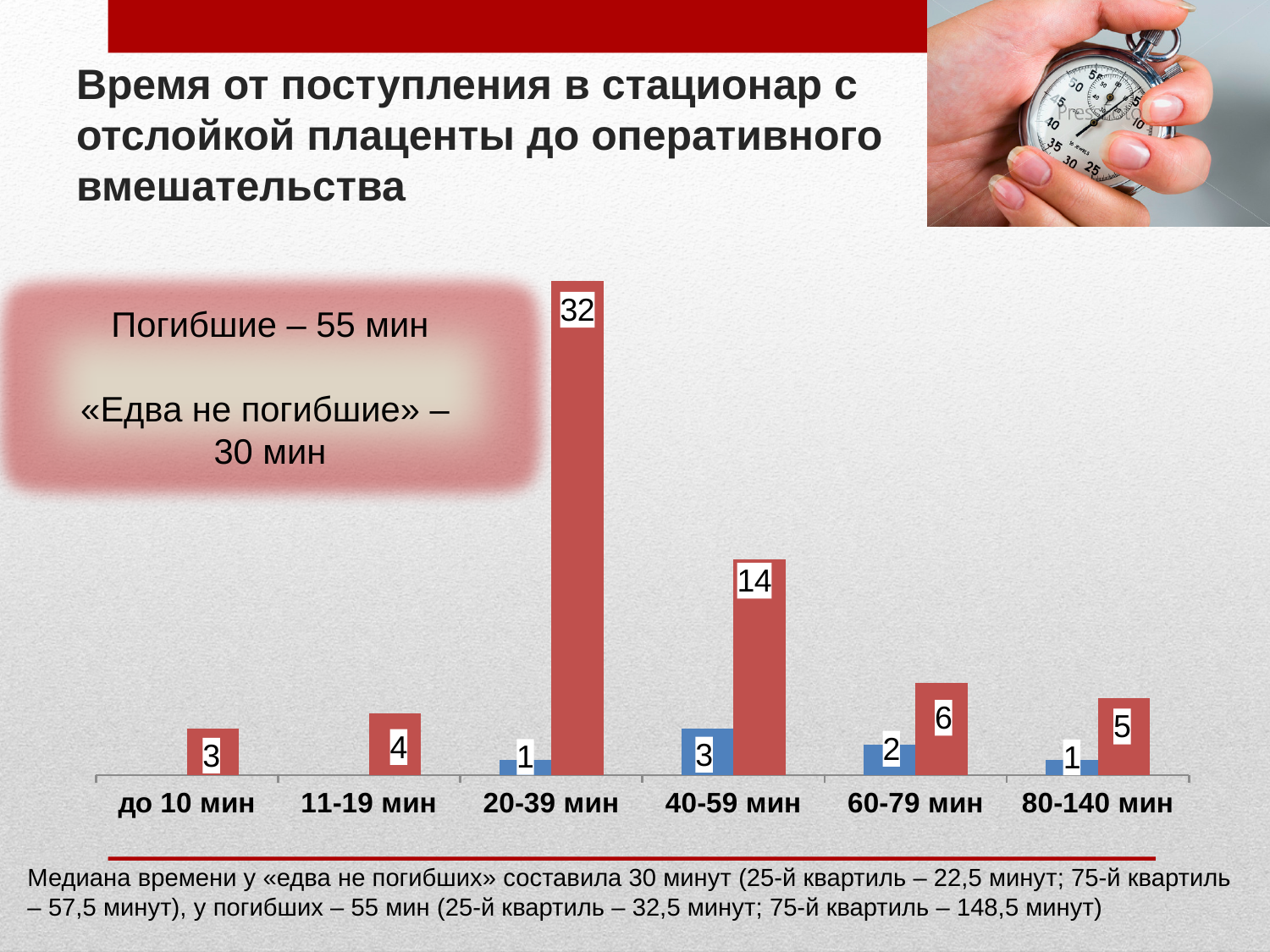
What is the value of the red bar for the 80-140 мин category? 5 Which category has the highest red bar? 20-39 мин What is the value of the red bar for the 20-39 мин category? 32 What is the difference between the red bar values for 20-39 мин and 40-59 мин? 18 Which is larger: the red bar for 60-79 мин or the red bar for 80-140 мин? 60-79 мин What kind of chart is shown on the slide? bar chart What is the value of the blue bar for the 40-59 мин category? 3 How many categories are shown on the x axis of the chart? 6 What is the difference between the red and blue bar values for the 60-79 мин category? 4 Which category has the highest blue bar? 40-59 мин What is the value of the red bar for the 40-59 мин category? 14 Which category has the lowest red bar? до 10 мин